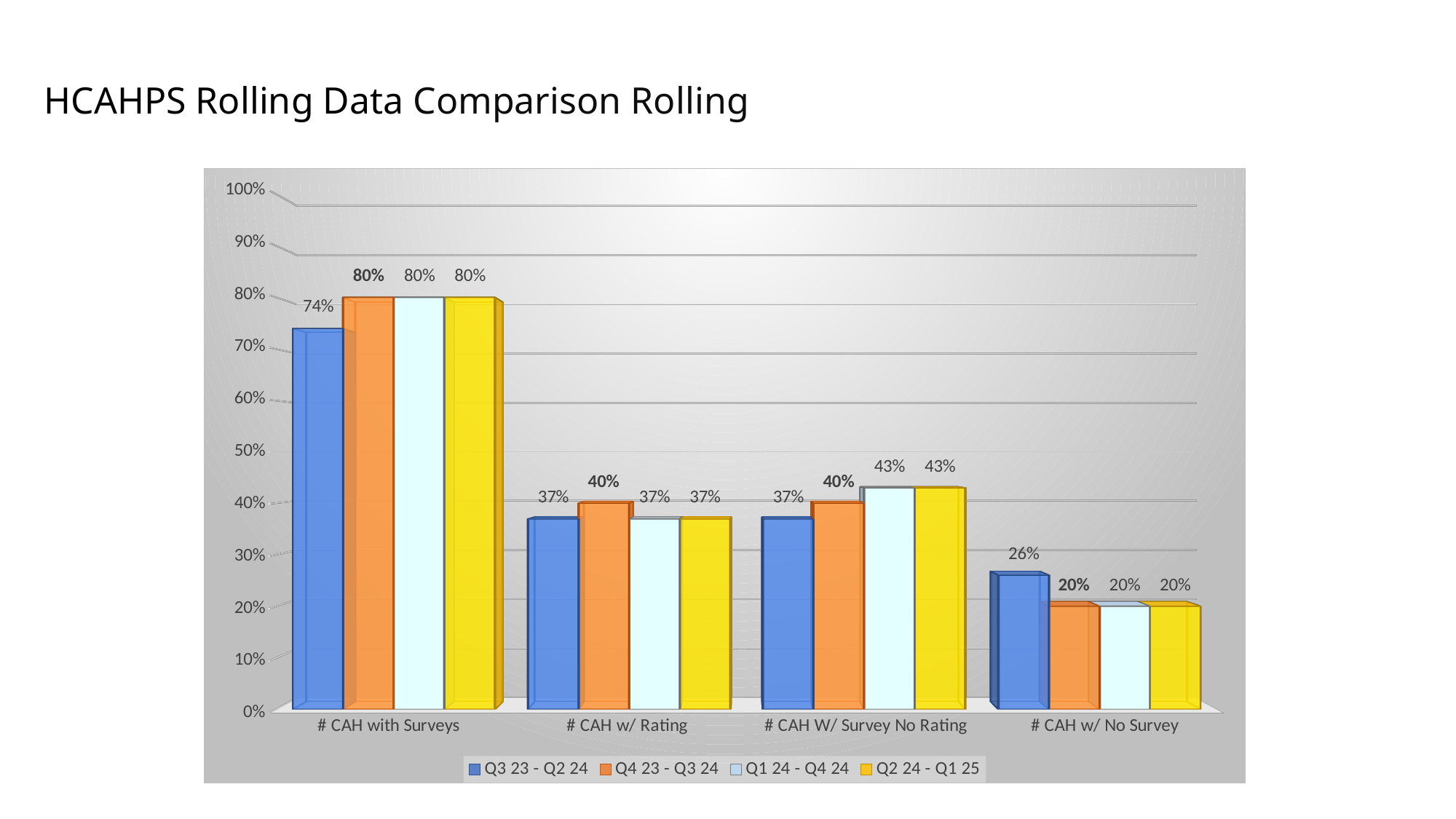
Which category has the lowest value for the Q2 24 - Q1 25 series? # CAH w/ No Survey What is the difference between the Q4 23 - Q3 24 and Q3 23 - Q2 24 values in the # CAH with Surveys category? 6% Which category has the highest value for the Q3 23 - Q2 24 series? # CAH with Surveys What is the value for Q4 23 - Q3 24 in the # CAH w/ Rating category? 40% What is the value for Q1 24 - Q4 24 in the # CAH w/ No Survey category? 20% What kind of chart is shown on the slide? Bar chart In the # CAH w/ No Survey category, which is larger: the Q3 23 - Q2 24 value or the Q4 23 - Q3 24 value? Q3 23 - Q2 24 What is the value for Q2 24 - Q1 25 in the # CAH W/ Survey No Rating category? 43% How many series does the legend list? 4 What is the title of the slide? HCAHPS Rolling Data Comparison Rolling How many categories are shown on the x axis? 4 What is the value for Q3 23 - Q2 24 in the # CAH with Surveys category? 74%